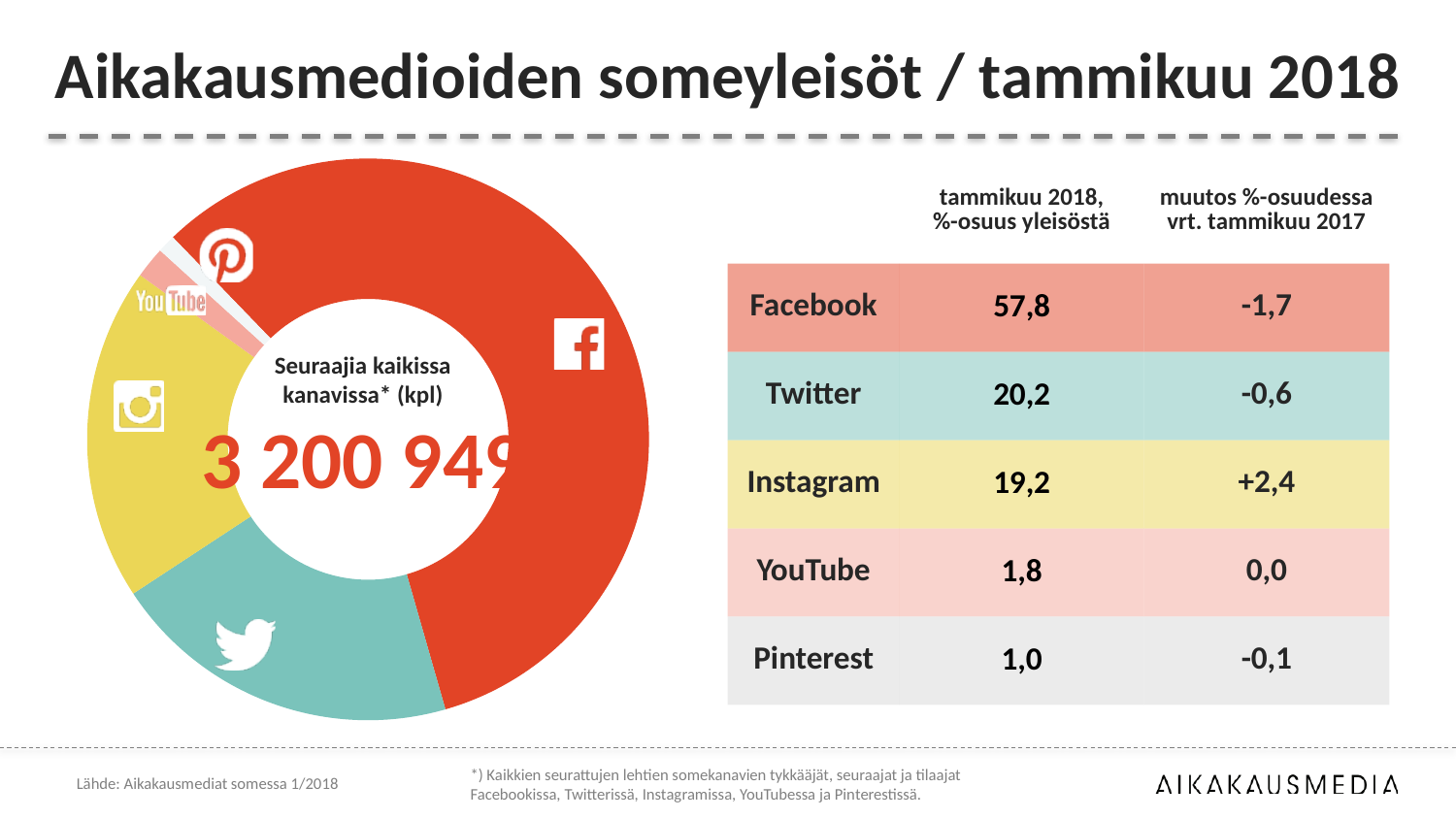
Which channel has the largest share of the audience in January 2018? Facebook What is YouTube's share of the audience in January 2018? 1,8 How many social media channels (slices) does the donut chart show? 5 What is the difference in percentage share between Facebook and Twitter in January 2018? 37,6 Which channel has the smallest share of the audience in January 2018? Pinterest What is the change in Instagram's percentage share compared with January 2017? +2,4 What is the change in Facebook's percentage share compared with January 2017? -1,7 What is Facebook's share of the audience (%-osuus yleisöstä) in January 2018? 57,8 Which has the larger share of the audience, Twitter or Instagram? Twitter What kind of chart is shown on the left of the slide? Pie (donut) chart What is Instagram's share of the audience in January 2018? 19,2 What is the total number of followers across all channels shown in the centre of the donut chart? 3 200 949